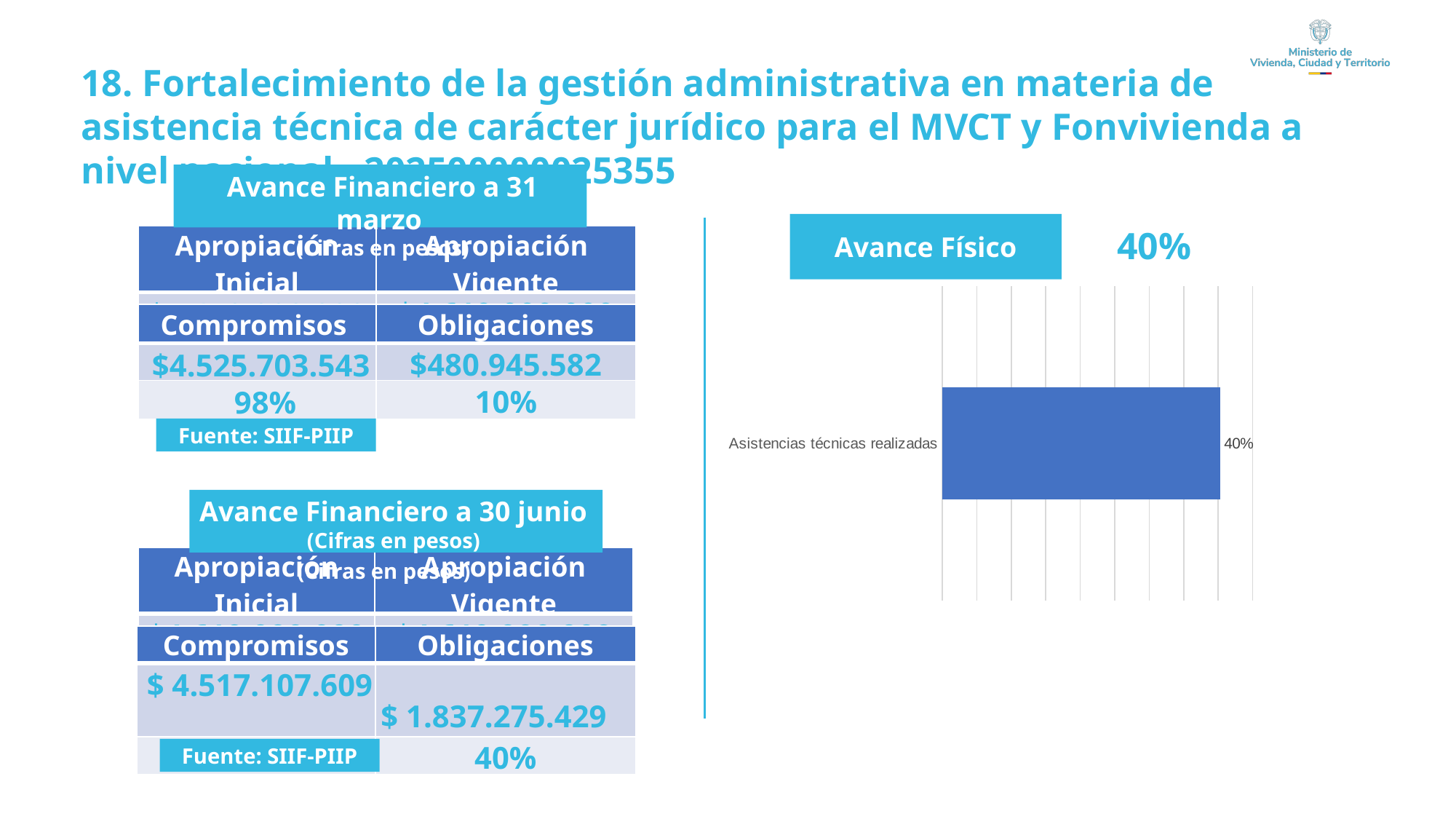
What is the title of the chart on the right side of the slide? Avance Físico What is the label of the single category plotted in the Avance Físico chart? Asistencias técnicas realizadas How many categories are plotted in the Avance Físico chart? 1 What is the value shown for "Asistencias técnicas realizadas" in the Avance Físico chart? 40% What kind of chart is the Avance Físico chart? Bar chart